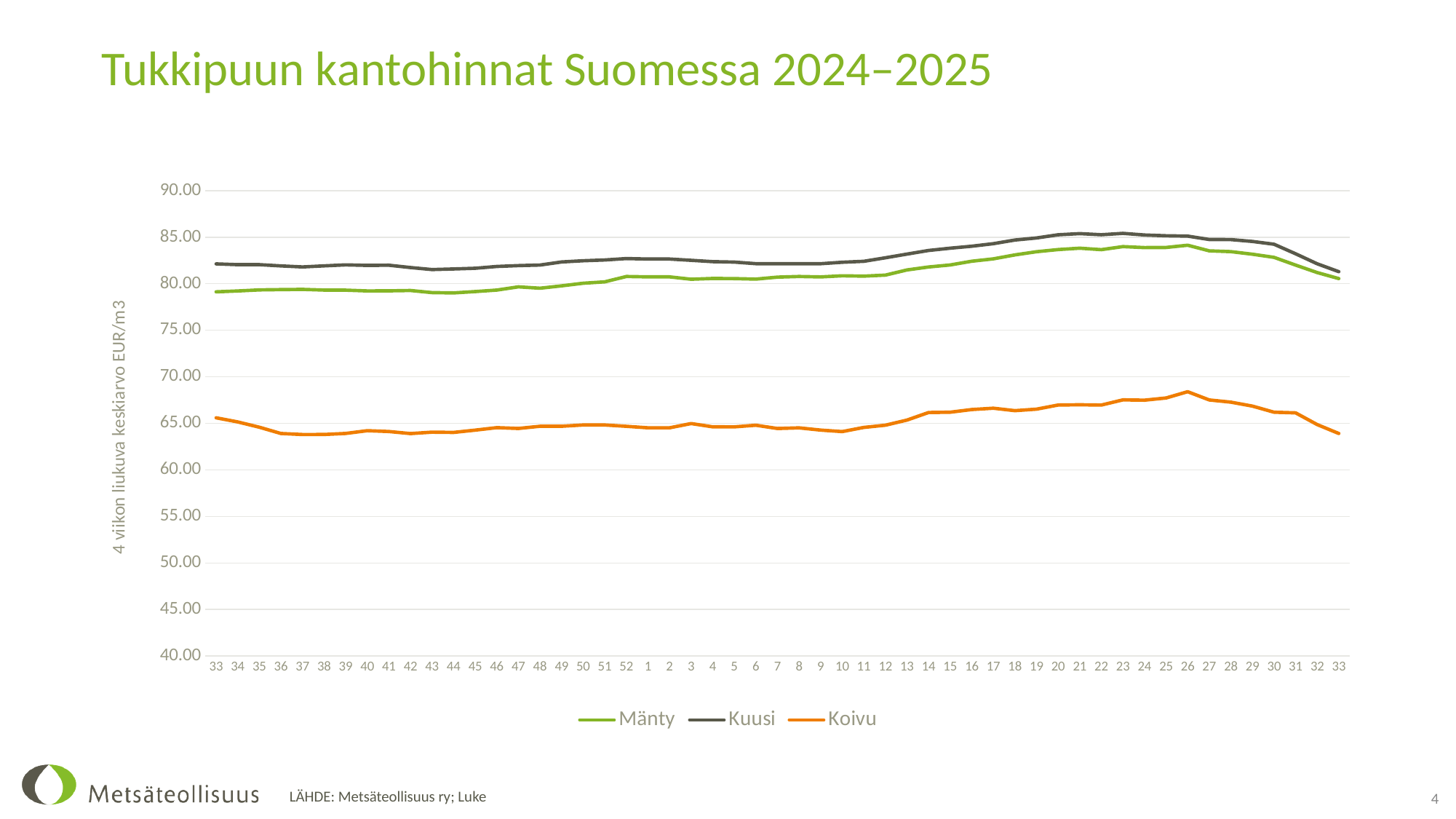
What is the label of the vertical axis? 4 viikon liukuva keskiarvo EUR/m3 Is the value for Koivu at week 26 greater or less than 65? greater At week 1, which is larger, Kuusi or Mänty? Kuusi Which series has the highest values throughout the chart? Kuusi Which series has the lowest values throughout the chart? Koivu Is the value for Mänty at week 44 greater or less than 80? less Is the value for Koivu at week 36 greater or less than 65? less What is the title of the chart? Tukkipuun kantohinnat Suomessa 2024–2025 How many series does the legend list? 3 Does the Koivu line rise or fall from week 26 to the final week 33? fall What kind of chart is shown on the slide? line chart